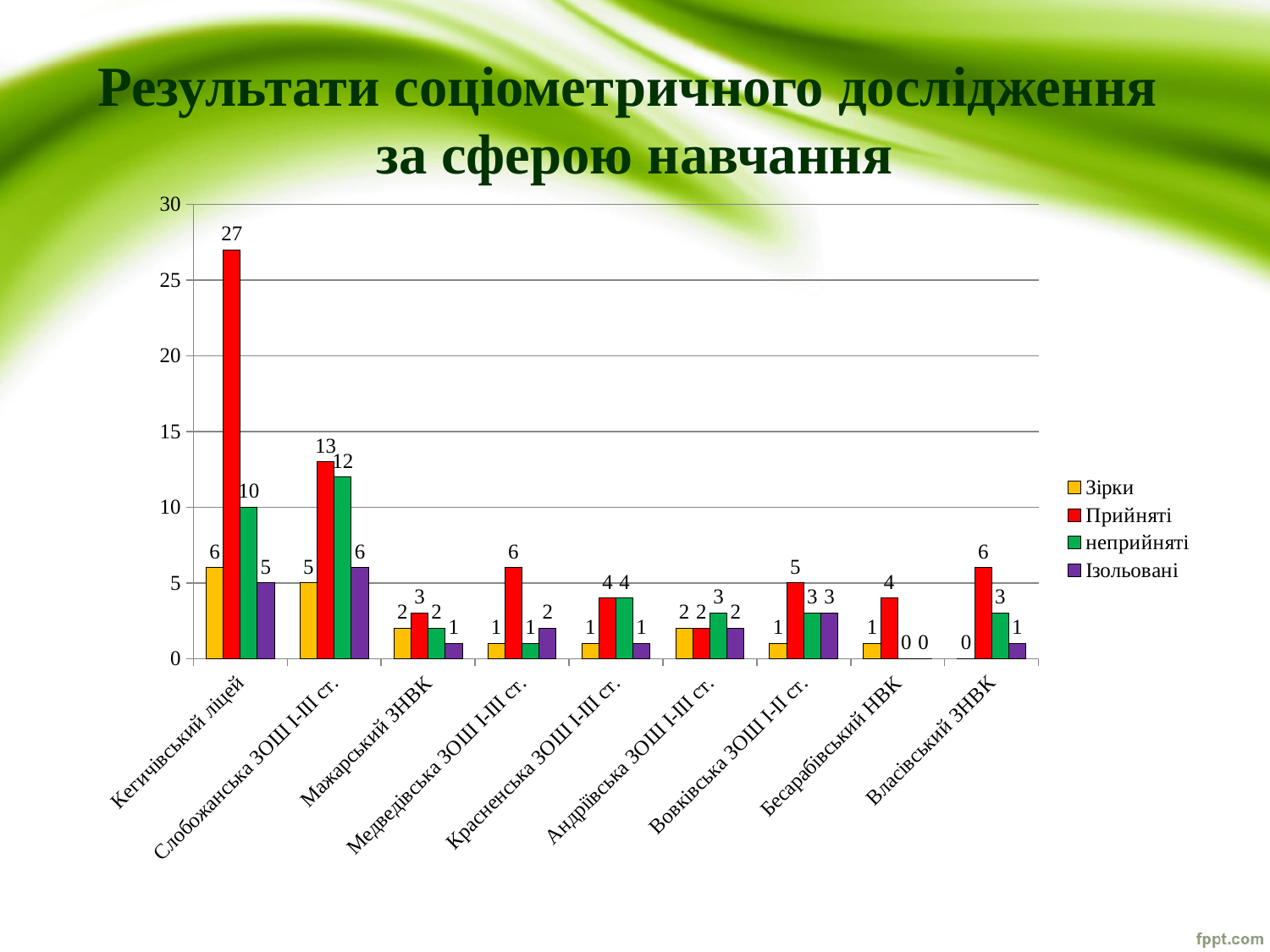
Which school has the lowest value for Зірки? Власівський ЗНВК How many series does the legend list? 4 Which is larger for Вовківська ЗОШ І-ІІ ст.: Прийняті or Зірки? Прийняті What is the value of Ізольовані for Медведівська ЗОШ І-ІІІ ст.? 2 What is the value of неприйняті for Слобожанська ЗОШ І-ІІІ ст.? 12 What is the difference between Прийняті and неприйняті for Кегичівський ліцей? 17 What type of chart is shown on the slide? bar chart What colour are the bars for the Ізольовані series? purple What is the value of Прийняті for Кегичівський ліцей? 27 Is the value of Прийняті for Кегичівський ліцей greater or less than 25? greater Which school has the highest value for Прийняті? Кегичівський ліцей How many schools (categories) are shown on the x axis? 9